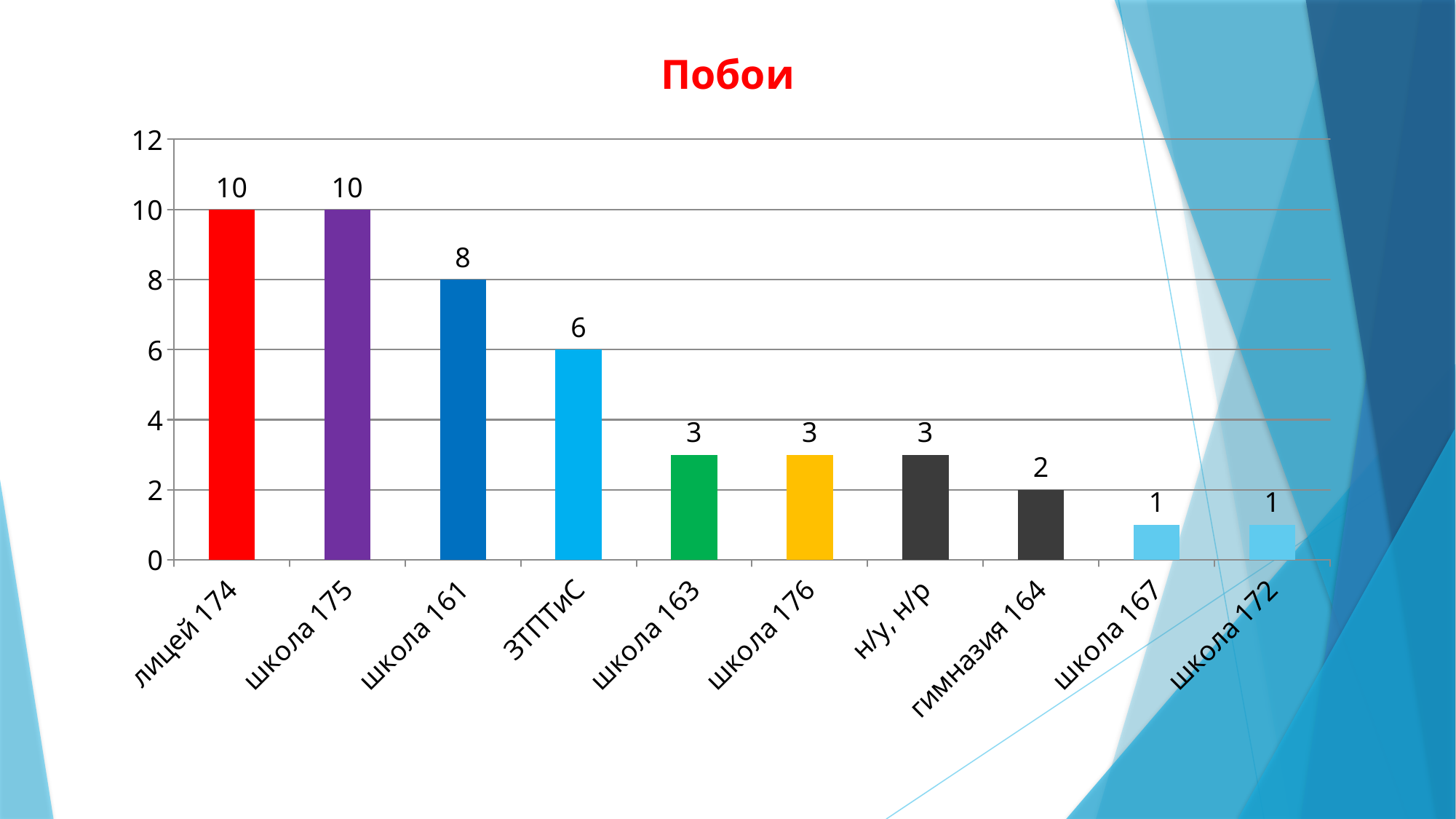
Which categories have the lowest value? школа 167 and школа 172 Which is larger, the value for школа 175 or the value for ЗТПТиС? школа 175 What kind of chart is shown on the slide? bar chart How many categories are shown on the x axis? 10 What is the value for ЗТПТиС? 6 What is the value for школа 161? 8 What is the difference between the values for ЗТПТиС and школа 163? 3 What is the title of the chart? Побои Which categories have the highest value? лицей 174 and школа 175 What is the difference between the values for лицей 174 and школа 161? 2 What is the value for гимназия 164? 2 What is the value for школа 167? 1